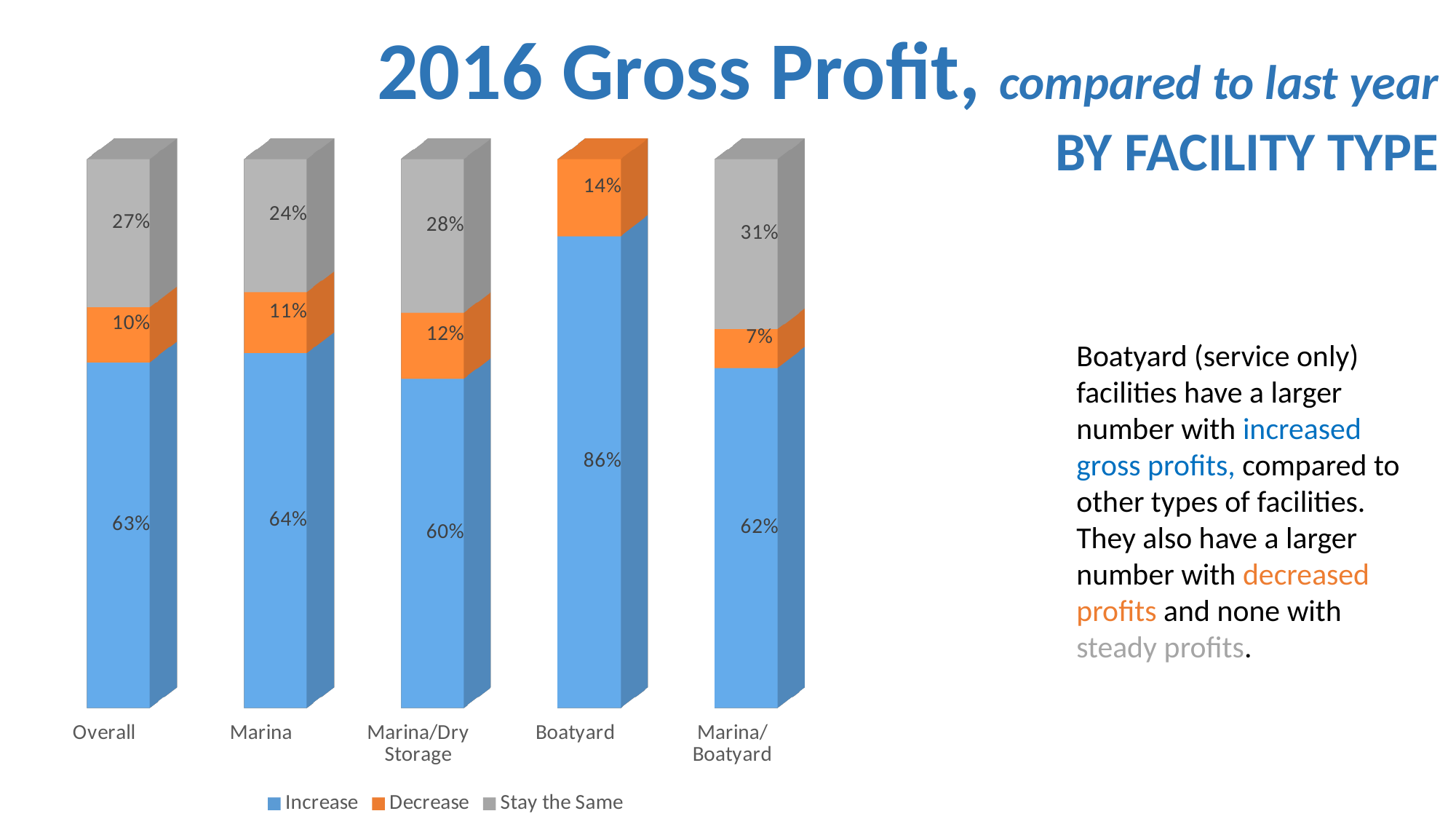
What is the total of the Increase and Decrease segments for Boatyard? 100% What is the Decrease value for Marina/Dry Storage? 12% Which facility type has the lowest Decrease percentage? Marina/Boatyard Which is larger, the Stay the Same value for Marina or for Marina/Dry Storage? Marina/Dry Storage How many facility type categories are shown on the x axis? 5 What is the Stay the Same value for Marina/Boatyard? 31% How many series does the legend list? 3 What is the Increase value for the Overall category? 63% What percentage of Boatyard facilities reported an Increase in gross profit? 86% Which facility type has the highest Increase percentage? Boatyard What kind of chart is shown on the slide? Stacked bar chart What is the difference between the Increase values for Boatyard and Marina? 22%